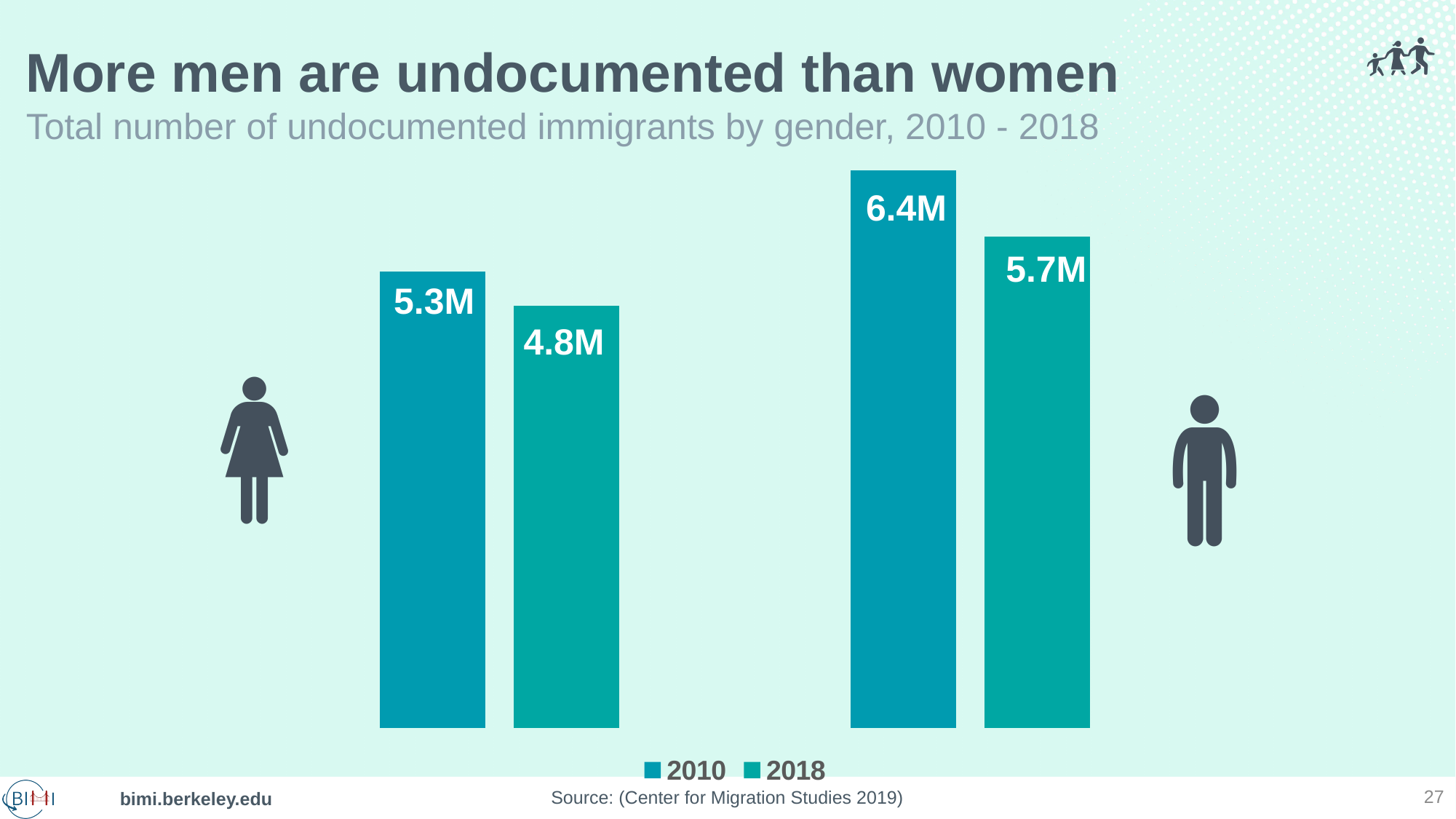
What was the number of undocumented men in 2010? 6.4M In 2018, which group had more undocumented immigrants, men or women? Men By how much did the number of undocumented women fall from 2010 to 2018? 0.5M What was the number of undocumented men in 2018? 5.7M What was the number of undocumented women in 2018? 4.8M What is the source cited for the chart? Center for Migration Studies 2019 By how much did the number of undocumented men fall from 2010 to 2018? 0.7M How many series does the legend list? 2 What was the number of undocumented women in 2010? 5.3M Which bar shows the highest value on the chart? Men, 2010 (6.4M) What kind of chart is shown on the slide? Bar chart Which bar shows the lowest value on the chart? Women, 2018 (4.8M)